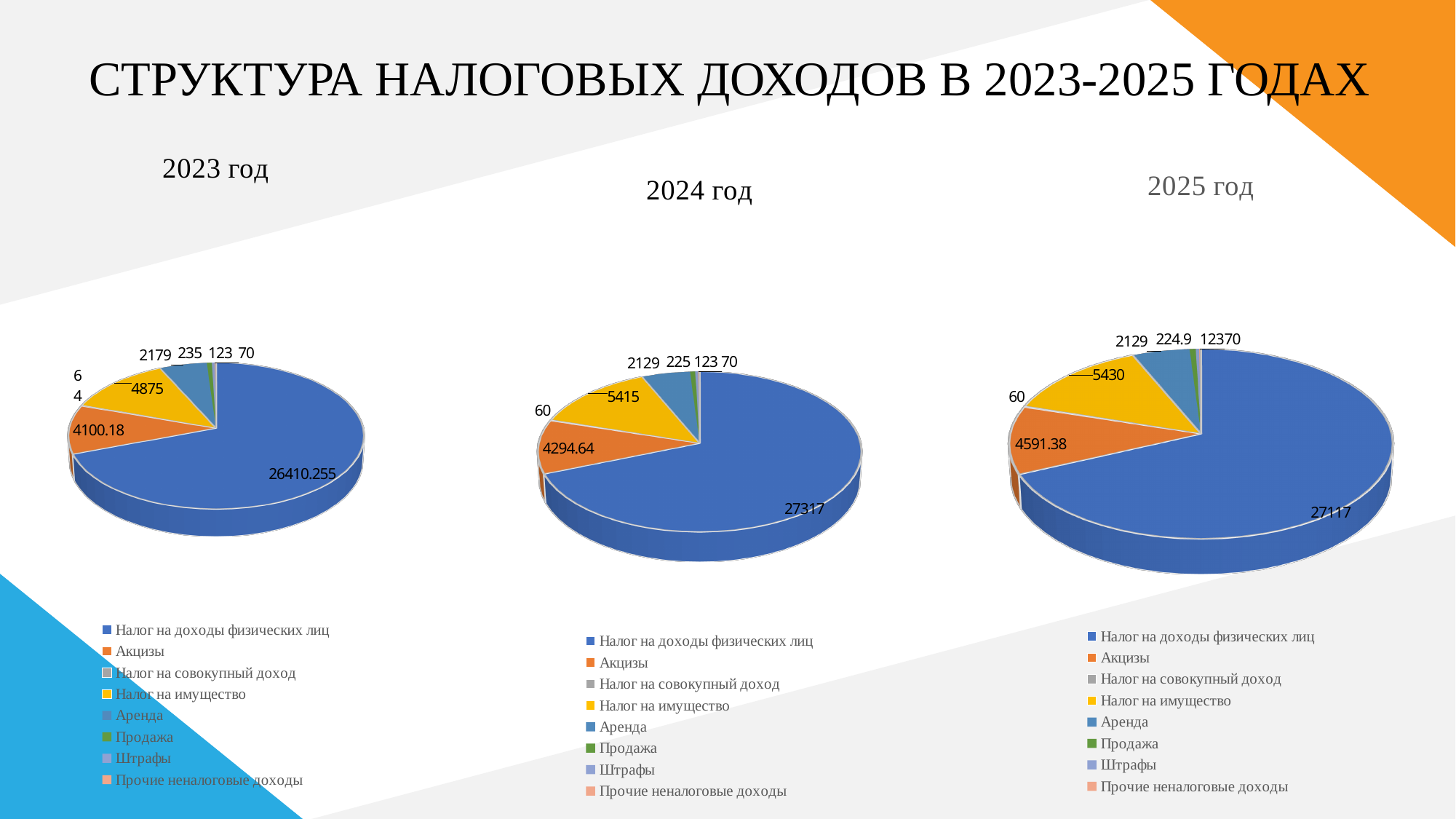
What kind of chart is used for the 2023 год data? pie chart In the 2025 год chart, what is the value for Акцизы? 4591.38 What is the difference between the Налог на имущество values in the 2025 год chart and the 2024 год chart? 15 How many categories does the legend of the 2025 год chart list? 8 In the 2024 год chart, what is the value for Налог на доходы физических лиц? 27317 In the 2024 год chart, which category has the largest slice? Налог на доходы физических лиц What is the difference between the Налог на доходы физических лиц values in the 2024 год chart and the 2025 год chart? 200 How many pie charts are shown on the slide? 3 In the 2023 год chart, what is the value for Акцизы? 4100.18 In the 2023 год chart, which is larger: Акцизы or Налог на имущество? Налог на имущество In the 2023 год chart, what is the value for Налог на доходы физических лиц? 26410.255 In the 2025 год chart, what is the value for Налог на имущество? 5430